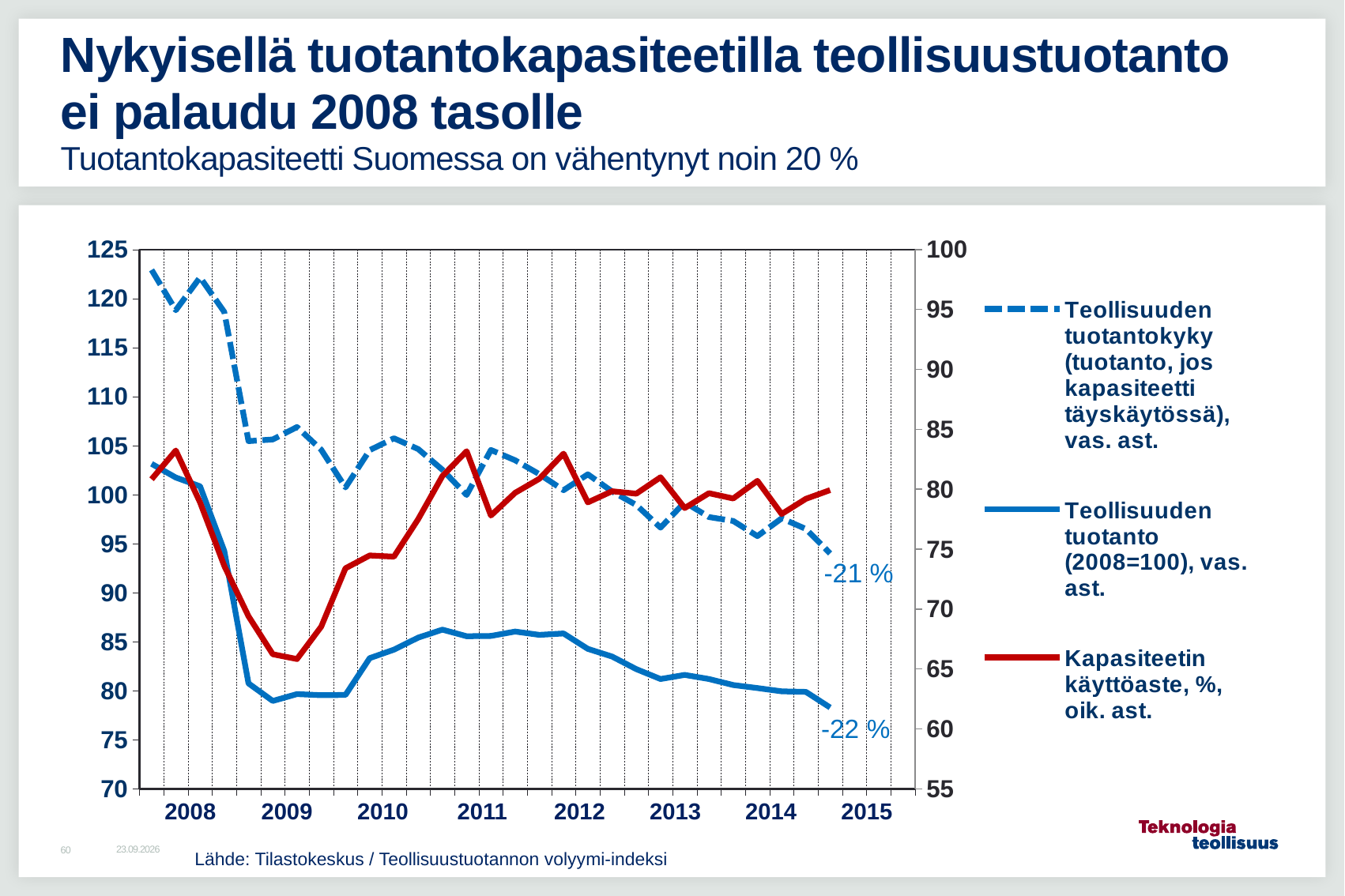
At the end of 2014, which is higher on the left axis: 'Teollisuuden tuotantokyky' or 'Teollisuuden tuotanto (2008=100)'? Teollisuuden tuotantokyky How many year labels are shown on the x axis? 8 What percentage change is annotated at the end of the solid 'Teollisuuden tuotanto (2008=100)' line? -22 % What percentage change is annotated at the end of the dashed 'Teollisuuden tuotantokyky' line? -21 % Is the lowest point of 'Kapasiteetin käyttöaste' in 2009 greater or less than 70 on the right axis? less Which axis does the 'Kapasiteetin käyttöaste, %' series use according to the legend? right axis (oik. ast.) Is the lowest point of 'Teollisuuden tuotanto (2008=100)' in 2009 greater or less than 85 on the left axis? less What kind of chart is shown on the slide? line chart Is the first plotted value of 'Teollisuuden tuotantokyky' in 2008 greater or less than 120 on the left axis? greater Does the 'Teollisuuden tuotanto (2008=100)' line rise or fall overall from 2008 to 2015? fall How many series does the legend list? 3